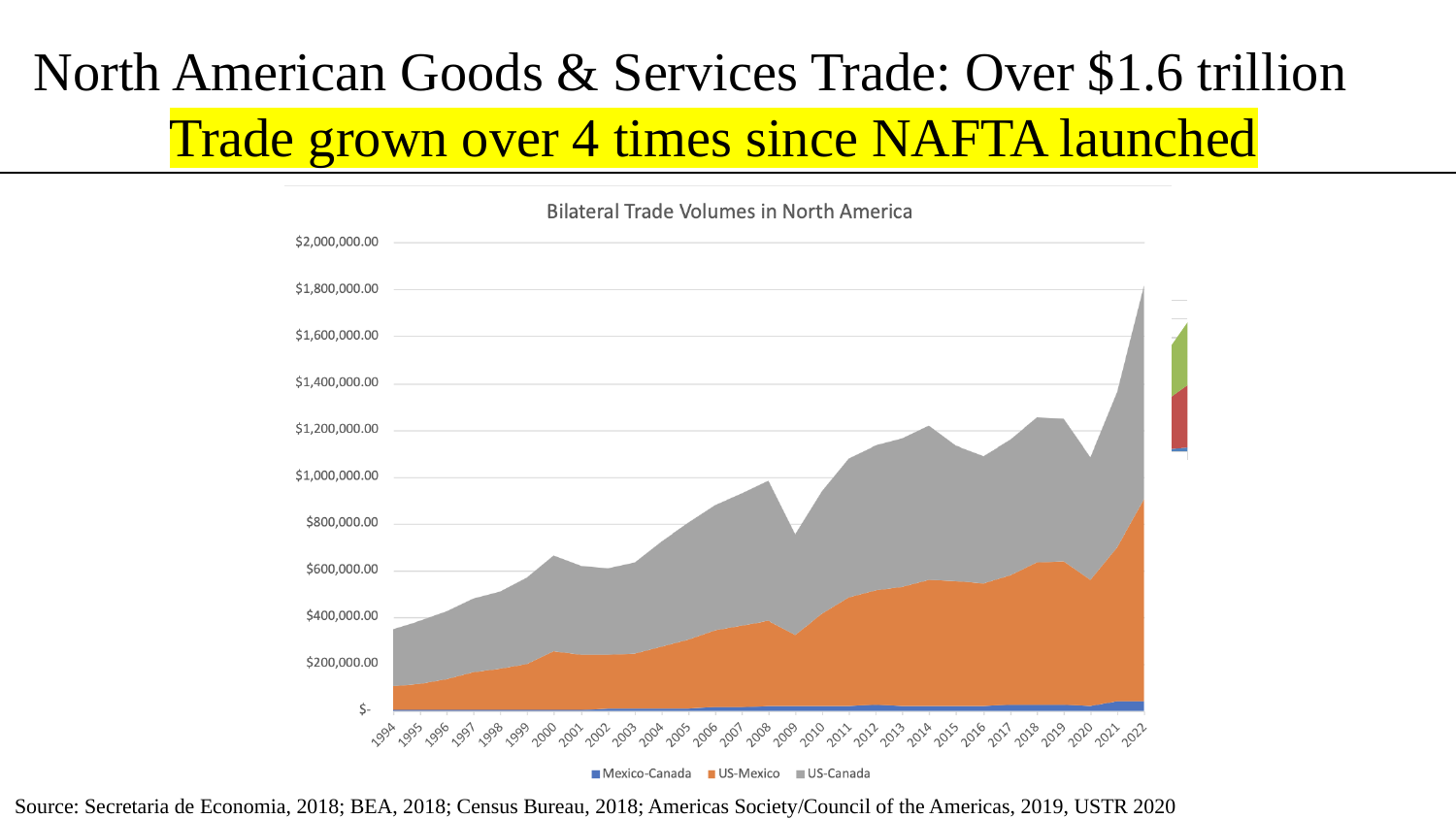
Which series is shown in orange in the chart? US-Mexico Overall, does total trade volume rise or fall from 1994 to 2022? rise Which series has the smallest trade volume throughout the chart? Mexico-Canada Is the total trade volume in 2011 greater or less than $1,000,000.00? greater Is the total trade volume in 2020 greater or less than $1,200,000.00? less What kind of chart is shown on the slide? Stacked area chart Is the total trade volume in 1994 greater or less than $400,000.00? less Which year has the larger total trade volume, 2008 or 2009? 2008 How many series does the chart's legend list? 3 What is the title of the chart? Bilateral Trade Volumes in North America How many years are plotted along the x axis of the chart? 29